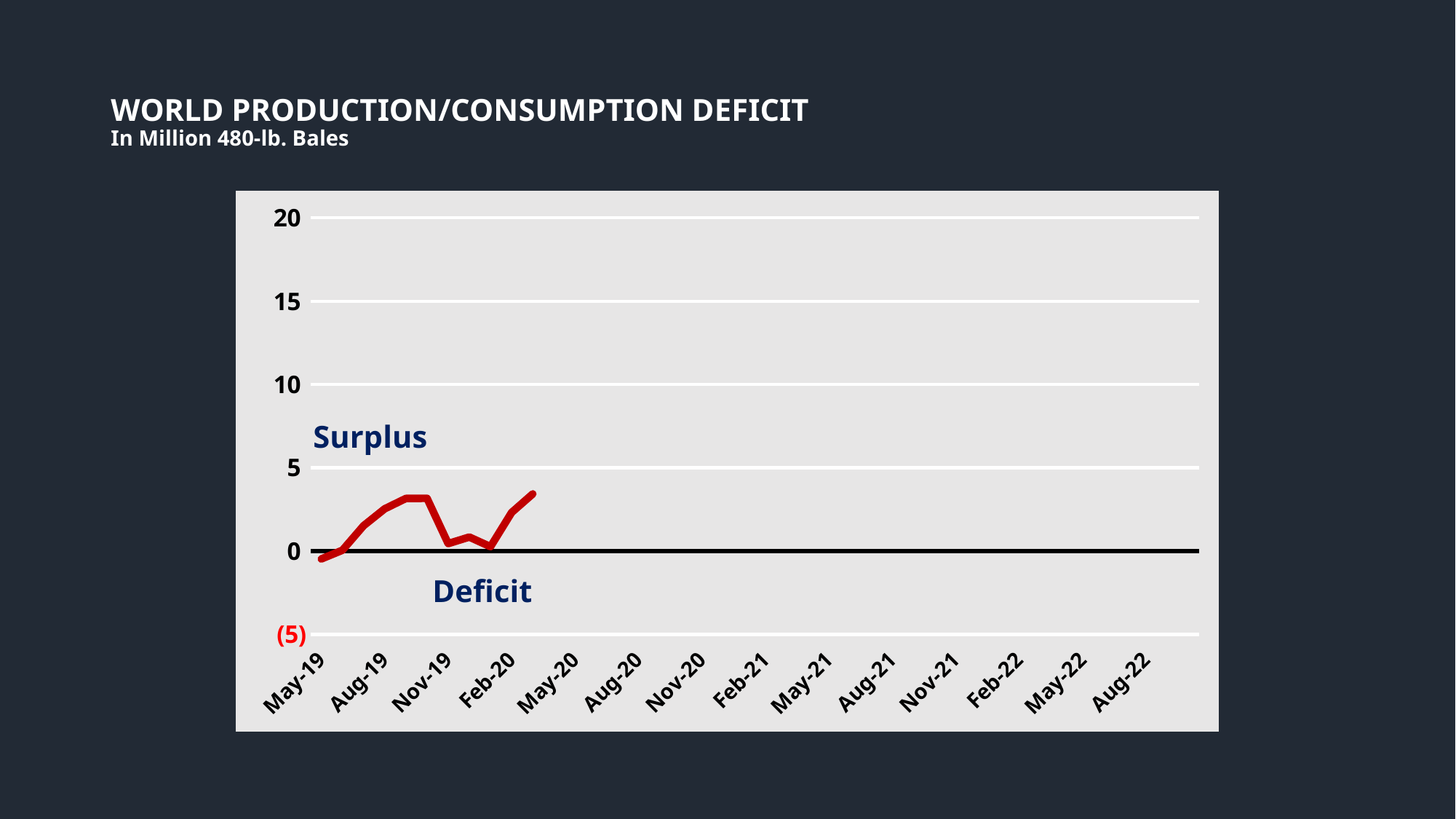
Is the value for Nov-19 greater or less than 5? less Does the line rise or fall between Nov-19 and Feb-20? rise What is the title of the chart on the slide? WORLD PRODUCTION/CONSUMPTION DEFICIT Does the line rise or fall between May-19 and Nov-19? rise What kind of chart is shown on the slide? line chart Is the value for Nov-19 greater or less than 0? greater Which is larger, the value for May-19 or the value for Aug-19? Aug-19 In what units are the values on the chart expressed, according to the subtitle? Million 480-lb. Bales How many date labels are shown along the x axis of the chart? 14 Is the value for Feb-20 greater or less than 5? less What is the highest value shown on the y axis of the chart? 20 Which is larger, the value for Nov-19 or the value for Feb-20? Feb-20